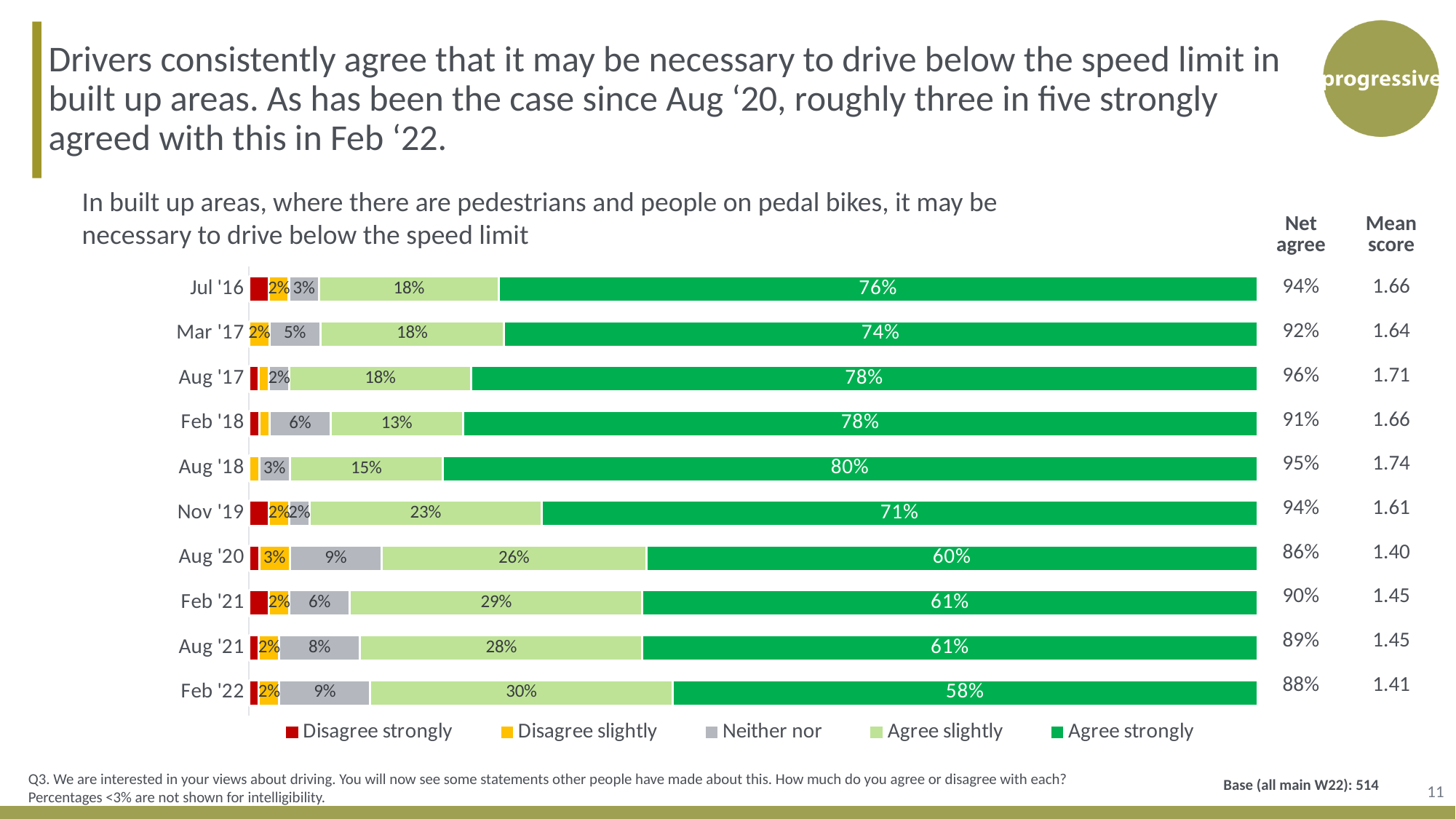
What percentage of drivers chose 'Agree strongly' in Feb '22? 58% How many survey waves (categories) are plotted on the chart? 10 What is the 'Agree slightly' value for Aug '20? 26% What is the 'Neither nor' value for Feb '22? 9% How many series does the chart legend list? 5 From Aug '18 to Feb '22, does the 'Agree strongly' share generally rise or fall? Fall In which wave was the 'Agree strongly' share lowest? Feb '22 What is the difference between the 'Agree strongly' values for Jul '16 and Feb '22? 18 percentage points In which wave was the 'Agree strongly' share highest? Aug '18 Which legend entry is shown in dark green? Agree strongly Which is larger, the 'Neither nor' value for Aug '20 or for Feb '21? Aug '20 What kind of chart is shown on the slide? Stacked bar chart